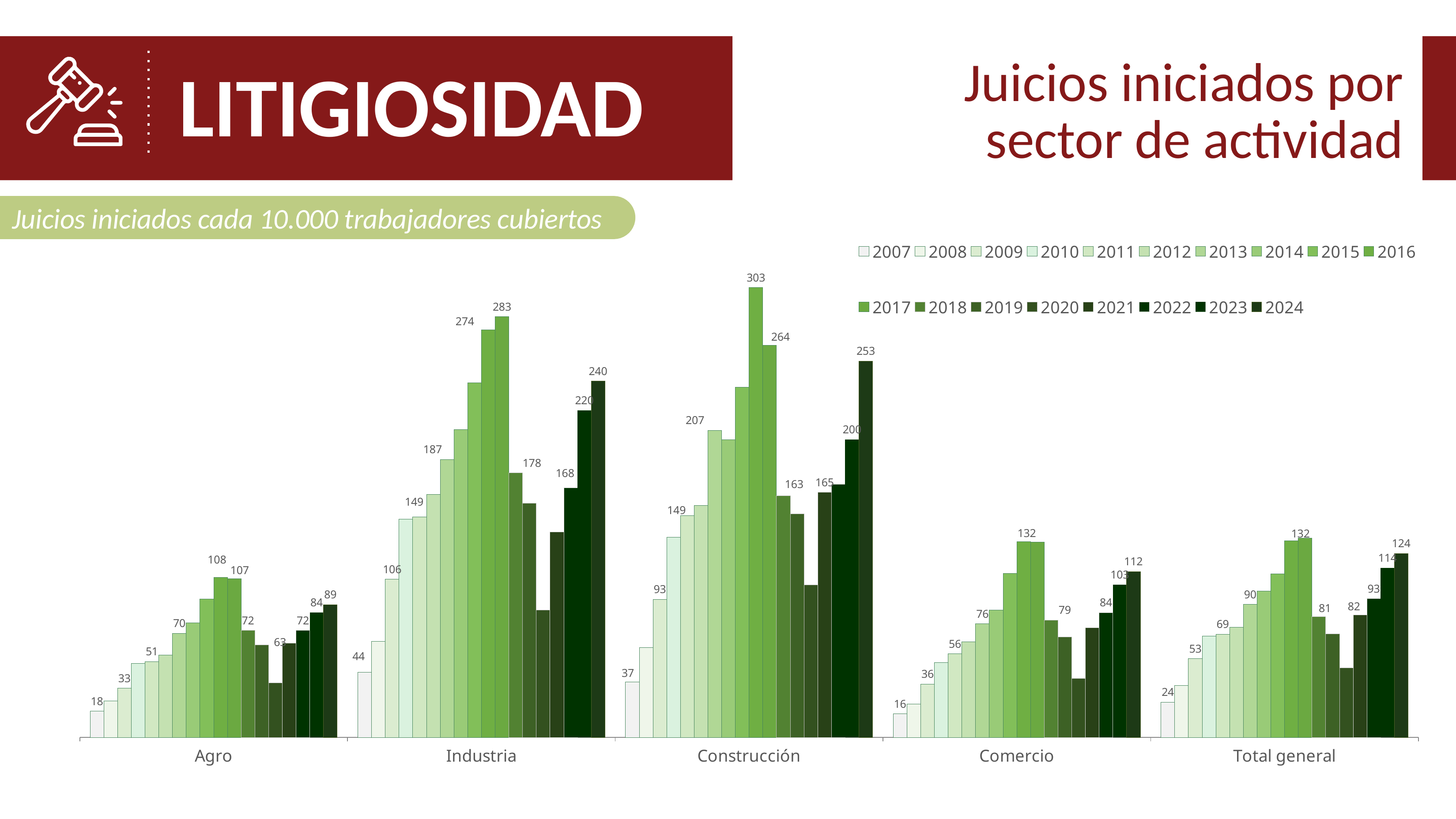
What is the value for Total general in 2024 (the last bar of the Total general group)? 124 How many series (years) does the legend list? 18 Which is larger, the 2024 value for Industria or the 2024 value for Construcción? Construcción What kind of chart is shown on the slide? bar chart What unit does the subtitle say the values are expressed in? Juicios iniciados cada 10.000 trabajadores cubiertos What is the value for Comercio in 2007 (the first bar of the Comercio group)? 16 What is the value for Agro in 2007 (the first bar of the Agro group)? 18 What is the difference between the 2024 and 2007 values for Industria? 196 What is the highest value labelled in the Construcción group? 303 What is the value for Construcción in 2024 (the last bar of the Construcción group)? 253 Which sector has the lowest value in 2007 (first bar of each group)? Comercio How many sector categories are shown along the x axis? 5